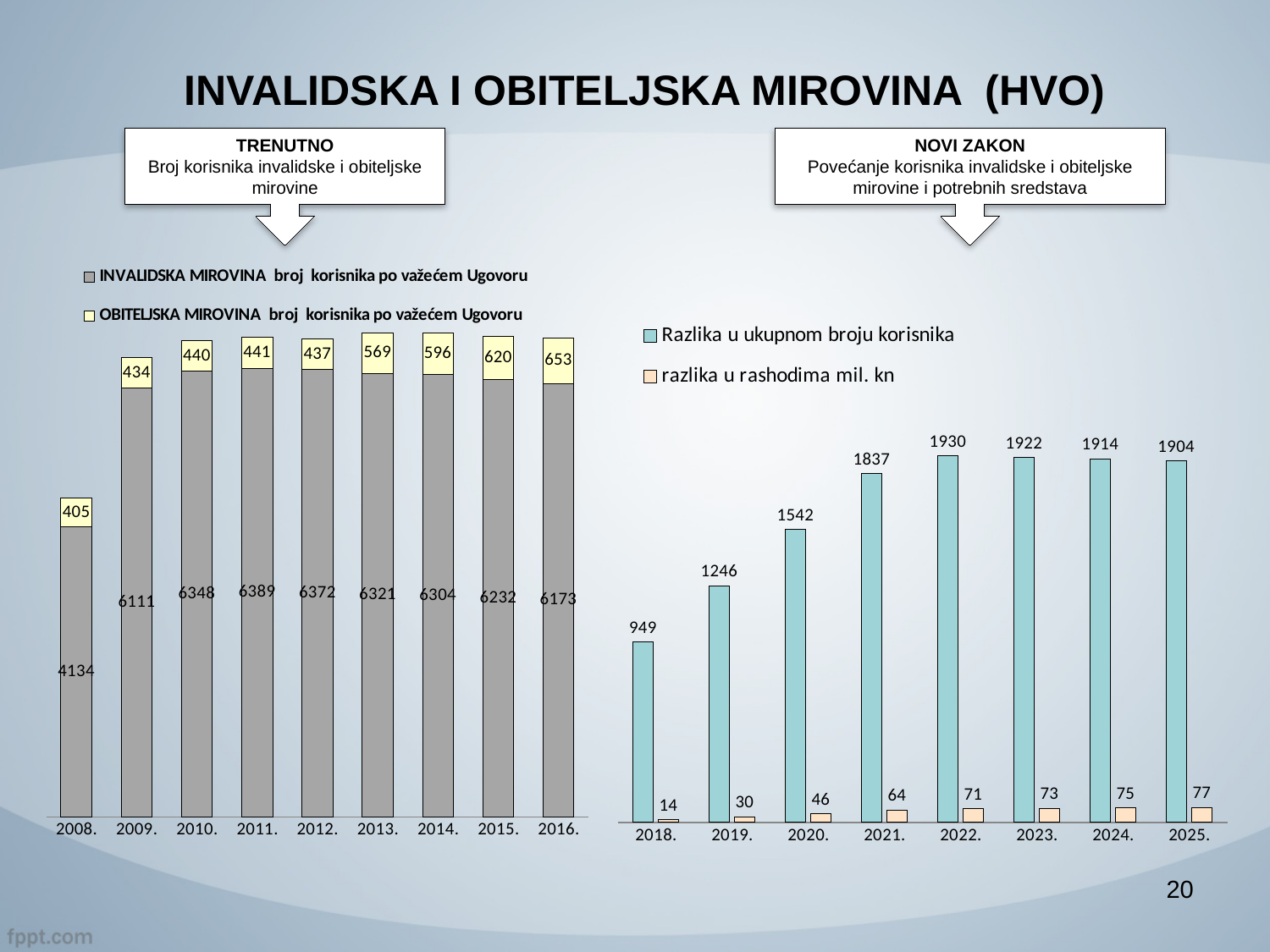
In the left chart, how many years are shown on the x axis? 9 In the right chart, what is the value of 'Razlika u ukupnom broju korisnika' for 2022.? 1930 In the left chart, which year has the lowest value for INVALIDSKA MIROVINA? 2008. In the right chart, how many series does the legend list? 2 In the left chart, what is the value for OBITELJSKA MIROVINA in 2016.? 653 What kind of chart is the right chart? bar chart In the right chart, does 'razlika u rashodima mil. kn' rise or fall from 2018. to 2025.? rise In the left chart, what is the value for INVALIDSKA MIROVINA in 2011.? 6389 In the left chart, what is the total of the stacked bar for 2008.? 4539 In the right chart, which year has the highest value for 'Razlika u ukupnom broju korisnika'? 2022. In the right chart, what is the value of 'razlika u rashodima mil. kn' for 2020.? 46 In the left chart, what is the difference between the INVALIDSKA MIROVINA values for 2010. and 2009.? 237